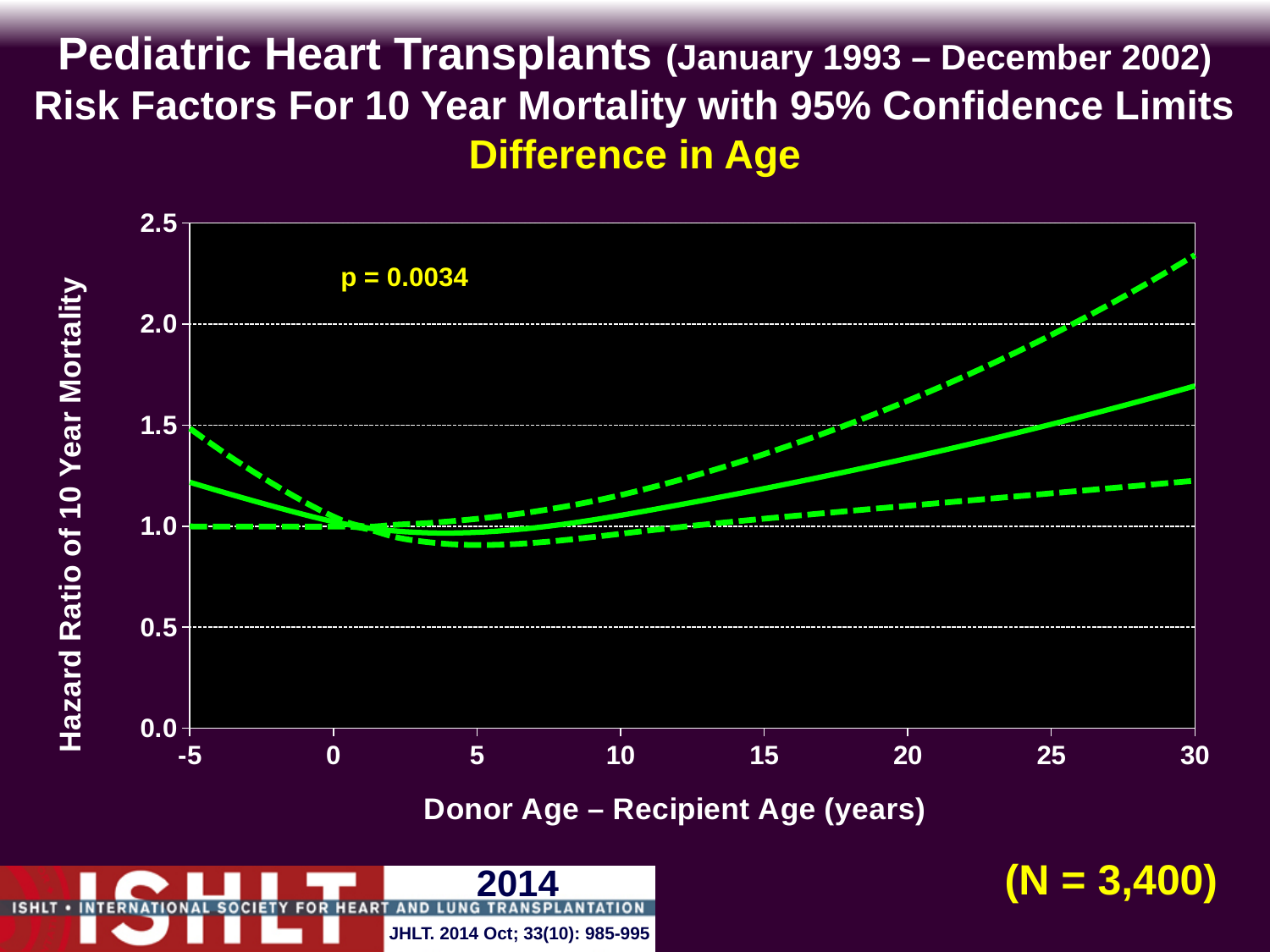
Is the lower dashed confidence limit at a donor-recipient age difference of 5 years greater or less than 1.0? less At which donor-recipient age difference shown on the x axis is the solid hazard ratio line highest? 30 How many lines are plotted on the chart? 3 Is the lower dashed confidence limit at a donor-recipient age difference of 30 years greater or less than 1.5? less What kind of chart is shown on the slide? Line chart Is the upper dashed confidence limit at a donor-recipient age difference of 30 years greater or less than 2.0? greater What p-value is printed on the chart? p = 0.0034 What sample size (N) is shown on the slide? N = 3,400 Does the solid hazard ratio line rise or fall as the donor-recipient age difference increases from 5 to 30 years? rise